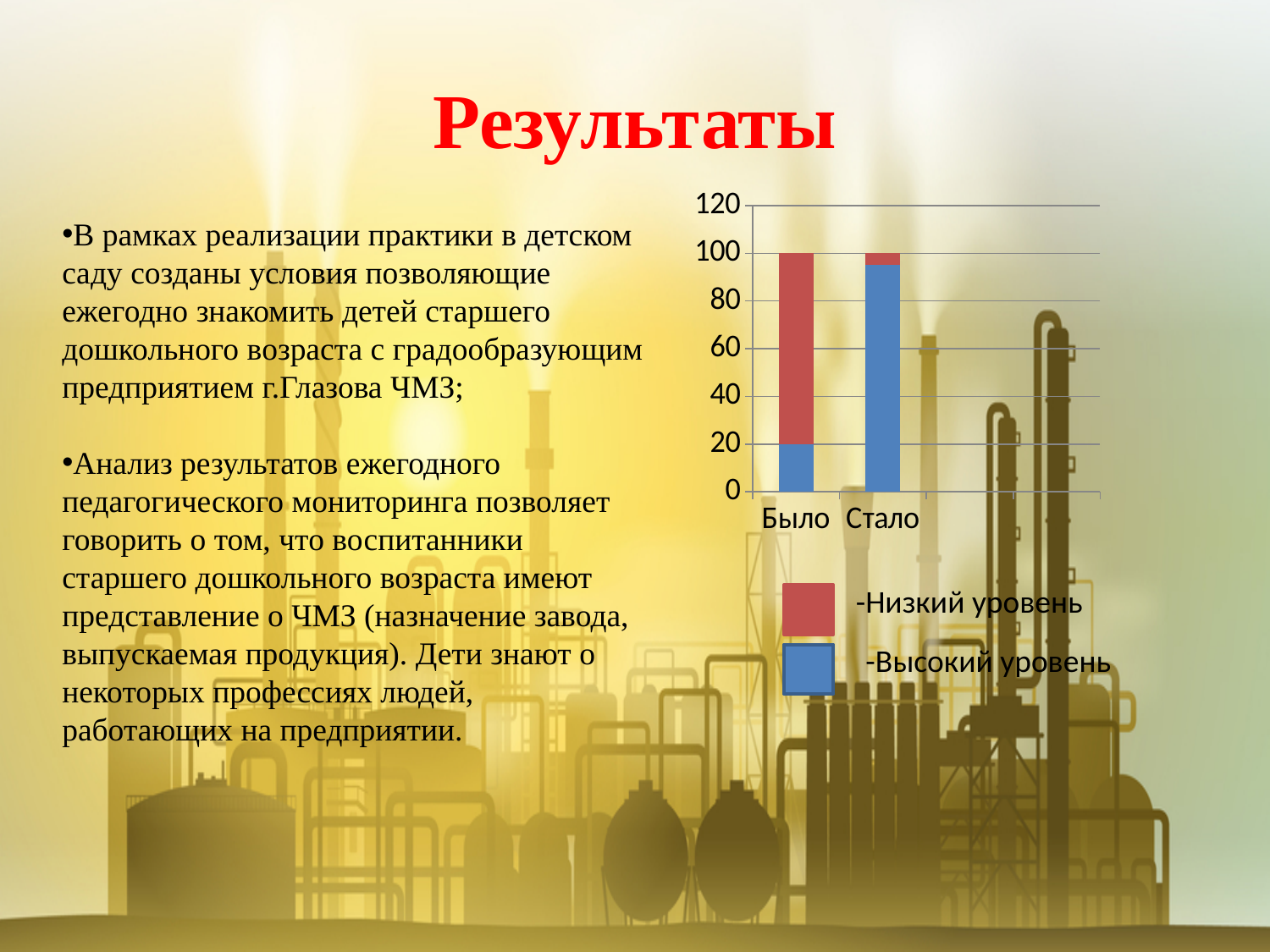
What is the total height of the stacked bar for Было? 100 Does the Высокий уровень value rise or fall from Было to Стало? rise Which colour represents Низкий уровень in the chart? red Is the value for Высокий уровень in the Было bar greater or less than 40? less Which category has the lowest Низкий уровень value? Стало What kind of chart is shown on the slide? bar chart How many categories are shown on the x axis of the chart? 2 Which category has the larger Низкий уровень value, Было or Стало? Было Which category has the larger Высокий уровень value, Было or Стало? Стало What are the two entries in the chart's legend? Низкий уровень, Высокий уровень Is the value for Высокий уровень in the Стало bar greater or less than 80? greater How many series does the chart's legend list? 2